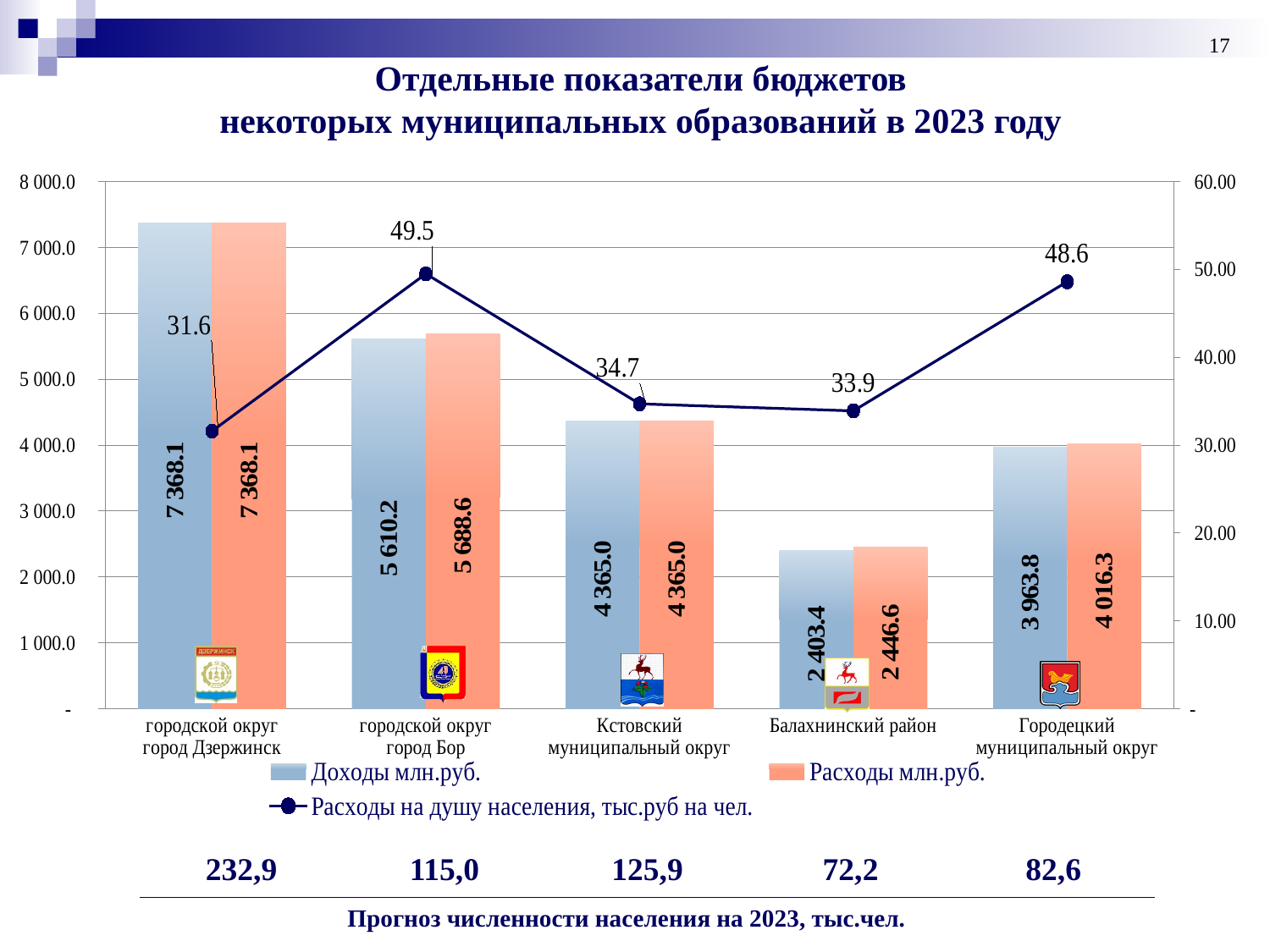
What is the difference between Расходы млн.руб. and Доходы млн.руб. for Балахнинский район? 43.2 What is the value of Доходы млн.руб. for городской округ город Бор? 5 610.2 What is the value of Расходы млн.руб. for Городецкий муниципальный округ? 4 016.3 How many series does the chart legend list? 3 Is the value of Доходы млн.руб. for городской округ город Дзержинск greater or less than 7 000.0? greater Which is larger for городской округ город Бор: Доходы млн.руб. or Расходы млн.руб.? Расходы млн.руб. What is the difference in Расходы на душу населения, тыс.руб на чел. between городской округ город Бор and городской округ город Дзержинск? 17.9 What is the value of Расходы на душу населения, тыс.руб на чел. for Кстовский муниципальный округ? 34.7 What kind of chart is used to show Доходы млн.руб. and Расходы млн.руб.? bar chart Which category has the lowest value of Доходы млн.руб.? Балахнинский район How many categories are shown on the x axis of the chart? 5 Which category has the highest value of Расходы на душу населения, тыс.руб на чел.? городской округ город Бор